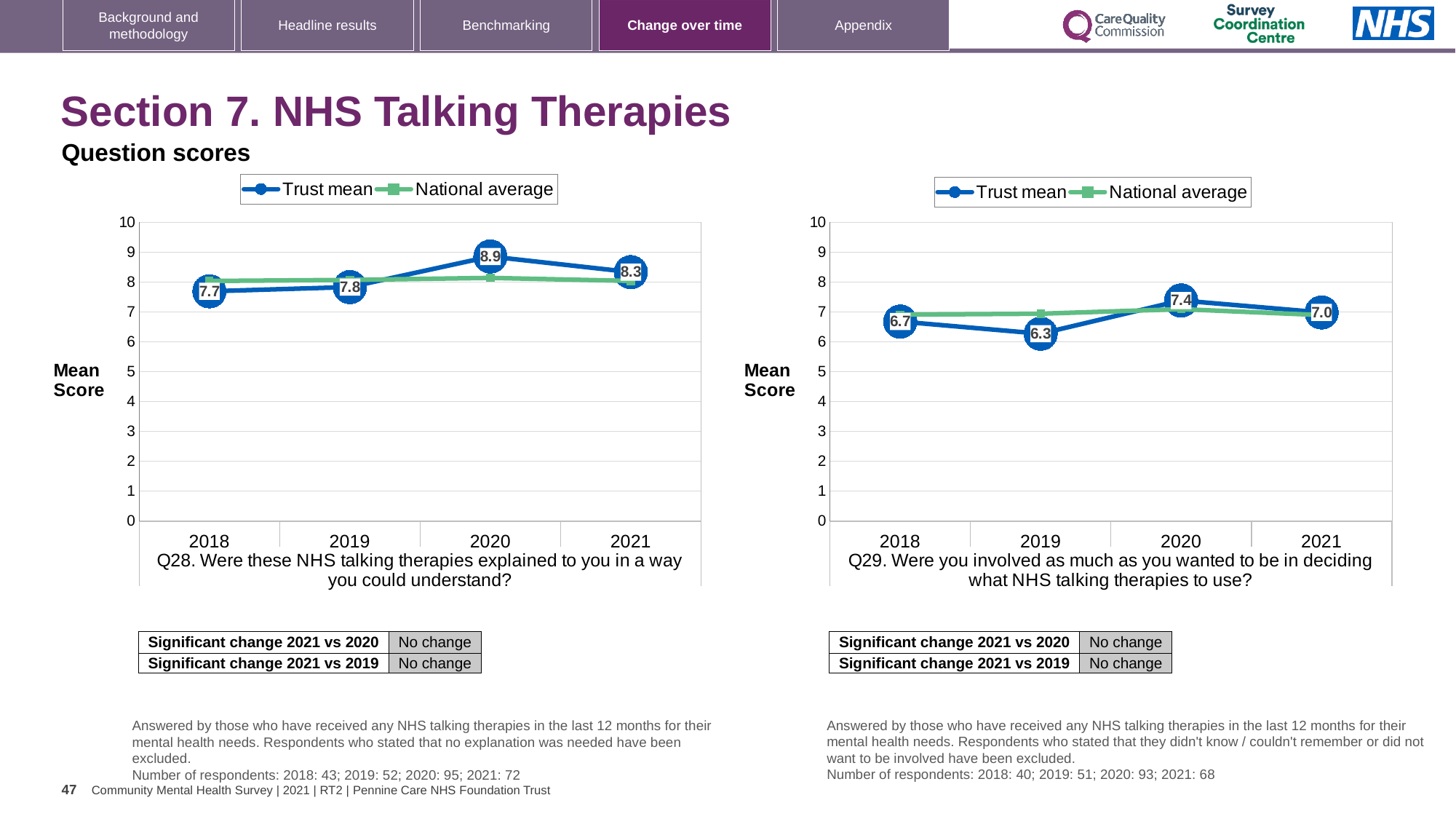
In the Q28 chart (left), is the National average for 2020 greater or less than 9? less In the Q29 chart (right), is the Trust mean for 2018 larger or smaller than the Trust mean for 2021? smaller In the Q29 chart (right), what is the Trust mean for 2021? 7.0 In the Q28 chart (left), what is the Trust mean for 2020? 8.9 In the Q29 chart (right), which year has the lowest Trust mean? 2019 What kind of chart is the Q28 chart (left)? line chart In the Q29 chart (right), what is the difference between the Trust mean for 2020 and the Trust mean for 2019? 1.1 In the Q29 chart (right), what is the Trust mean for 2019? 6.3 In the Q28 chart (left), what is the difference between the Trust mean for 2020 and the Trust mean for 2021? 0.6 How many years are plotted on the x axis of the Q29 chart (right)? 4 In the Q28 chart (left), which year has the highest Trust mean? 2020 In the Q28 chart (left), what is the Trust mean for 2018? 7.7